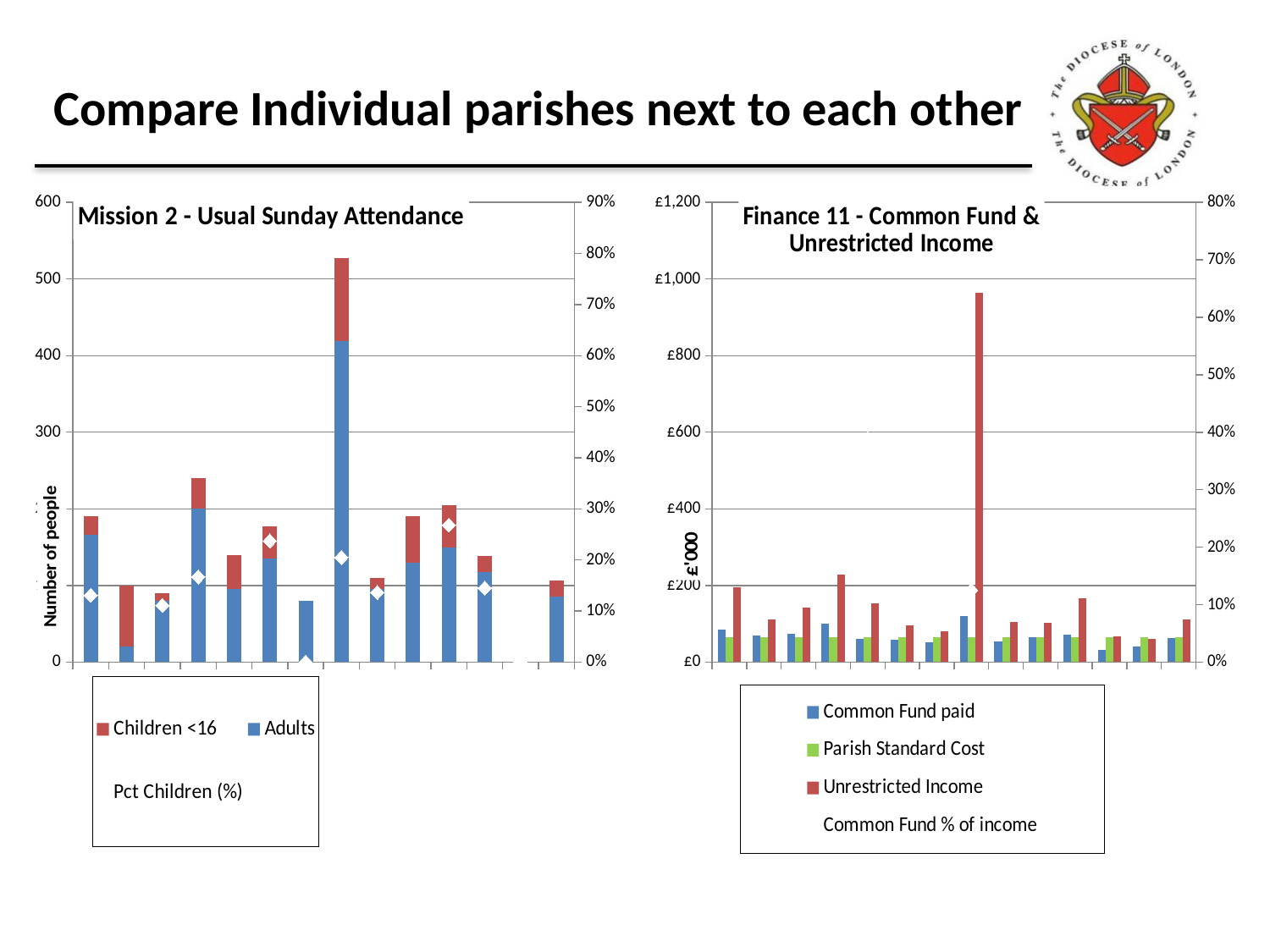
In the right chart, 'Finance 11 - Common Fund & Unrestricted Income', is the tallest bar greater or less than £1,000? less What kind of chart is the left chart, 'Mission 2 - Usual Sunday Attendance'? Stacked bar chart with a line In the right chart, 'Finance 11 - Common Fund & Unrestricted Income', is the tallest Unrestricted Income bar greater or less than £800? greater What kind of chart is the right chart, 'Finance 11 - Common Fund & Unrestricted Income'? Bar chart with a line In the left chart, 'Mission 2 - Usual Sunday Attendance', which series is shown in red? Children <16 How many series does the legend of the left chart, 'Mission 2 - Usual Sunday Attendance', list? 3 What is the label on the vertical axis of the right chart, 'Finance 11 - Common Fund & Unrestricted Income'? £'000 How many series does the legend of the right chart, 'Finance 11 - Common Fund & Unrestricted Income', list? 4 In the left chart, 'Mission 2 - Usual Sunday Attendance', is the tallest stacked bar greater or less than 500 people? greater